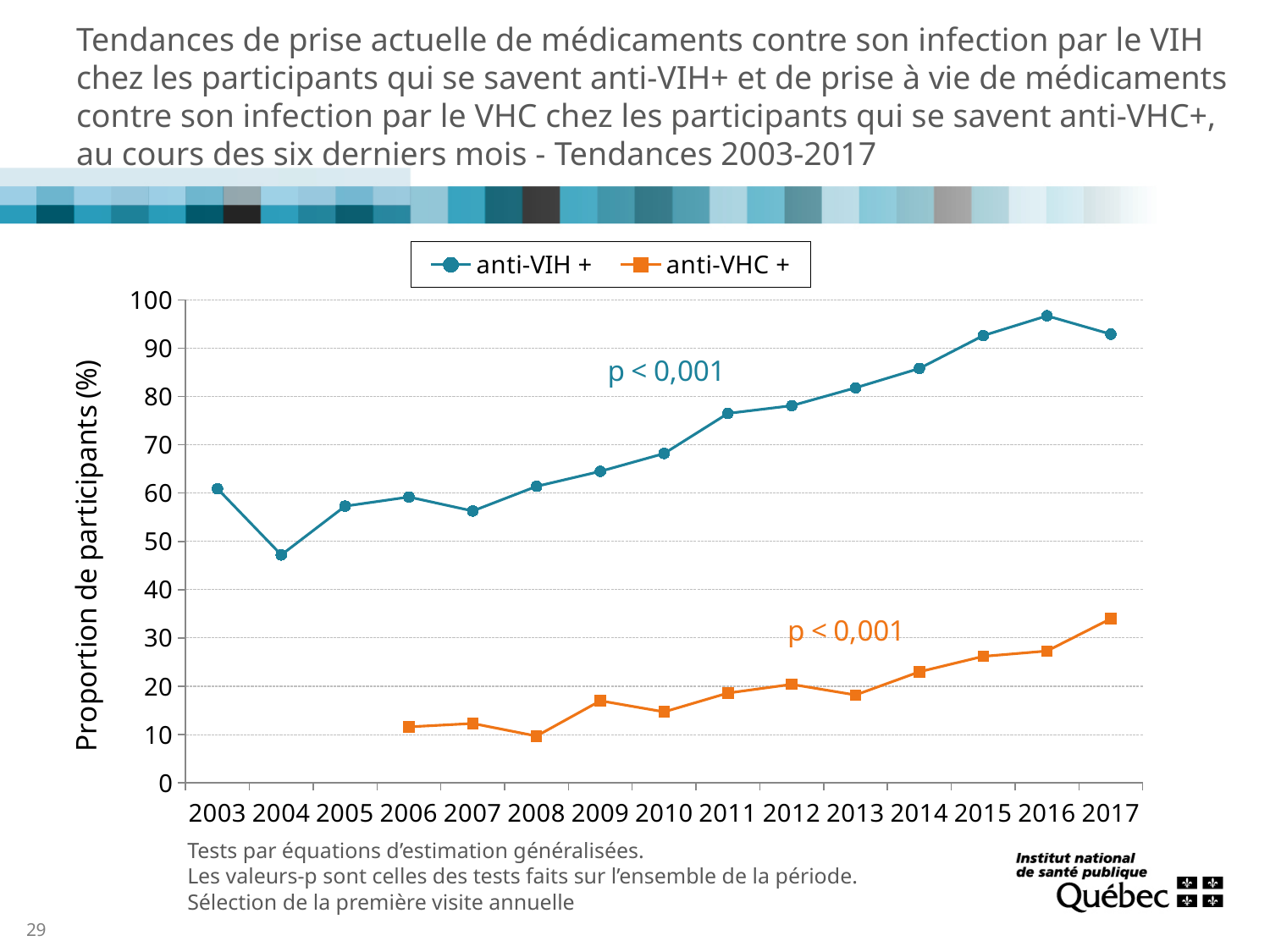
In which year is the anti-VIH + series at its lowest? 2004 In which year is the anti-VHC + series at its highest? 2017 What kind of chart is shown on the slide? line chart Does the anti-VHC + series overall rise or fall from 2011 to 2017? rise In which year is the anti-VHC + series at its lowest? 2008 How many years are shown on the x axis? 15 Is the anti-VHC + value for 2017 greater or less than 30? greater Which year has the larger anti-VIH + value, 2003 or 2004? 2003 In which year is the anti-VIH + series at its highest? 2016 Is the anti-VIH + value for 2004 greater or less than 50? less Is the anti-VIH + value for 2016 greater or less than 90? greater How many series does the legend list? 2